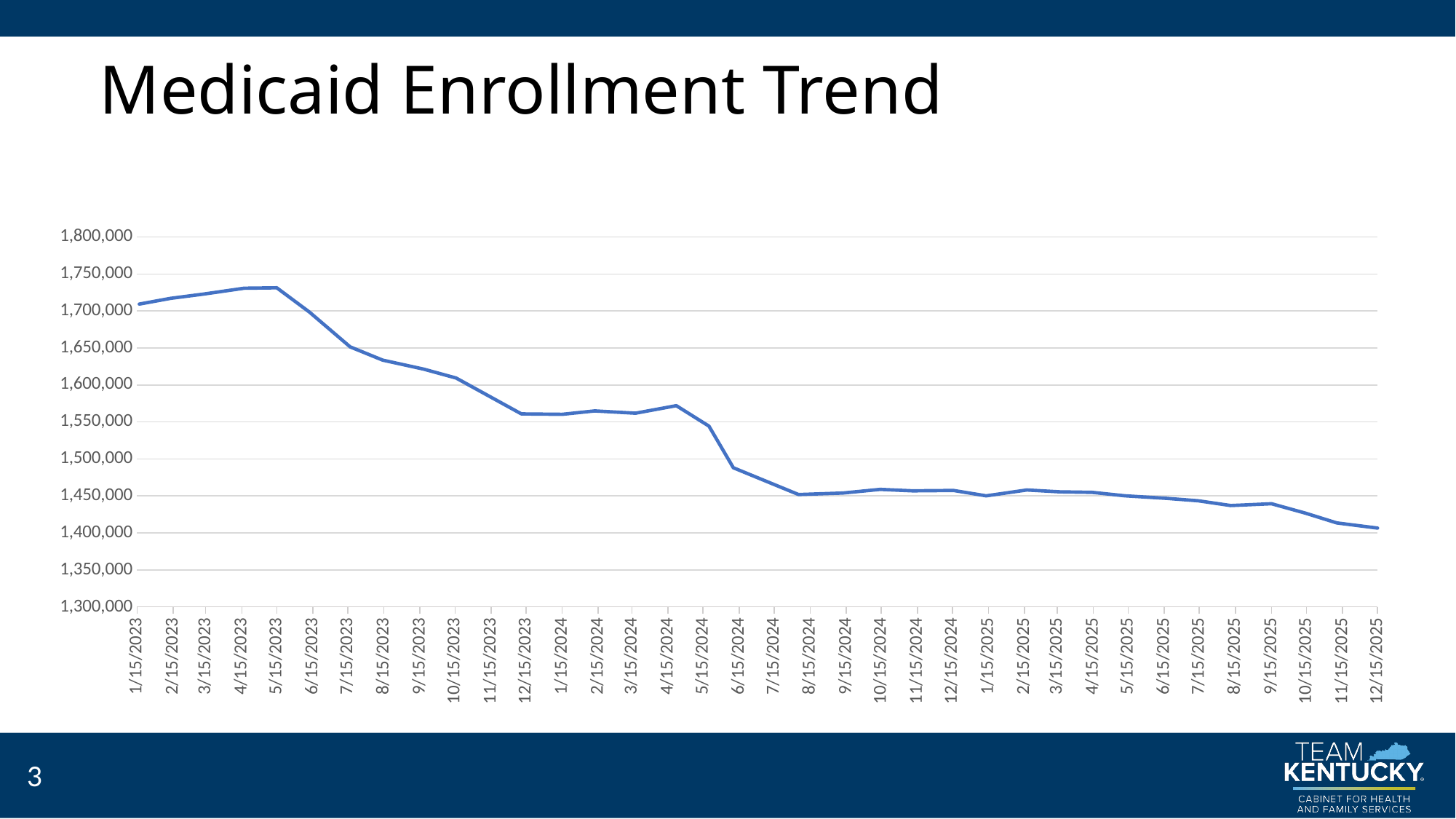
What kind of chart is shown on the slide? line chart Which is larger, the value for 1/15/2023 or the value for 12/15/2025? 1/15/2023 Is the value for 4/15/2024 greater or less than 1,550,000? greater Which is larger, the value for 5/15/2024 or the value for 6/15/2024? 5/15/2024 Overall, do the enrollment values rise or fall from 1/15/2023 to 12/15/2025? fall Is the value for 6/15/2024 greater or less than 1,500,000? less Is the value for 12/15/2023 greater or less than 1,600,000? less What is the highest value shown on the y axis? 1,800,000 What is the title of the chart? Medicaid Enrollment Trend